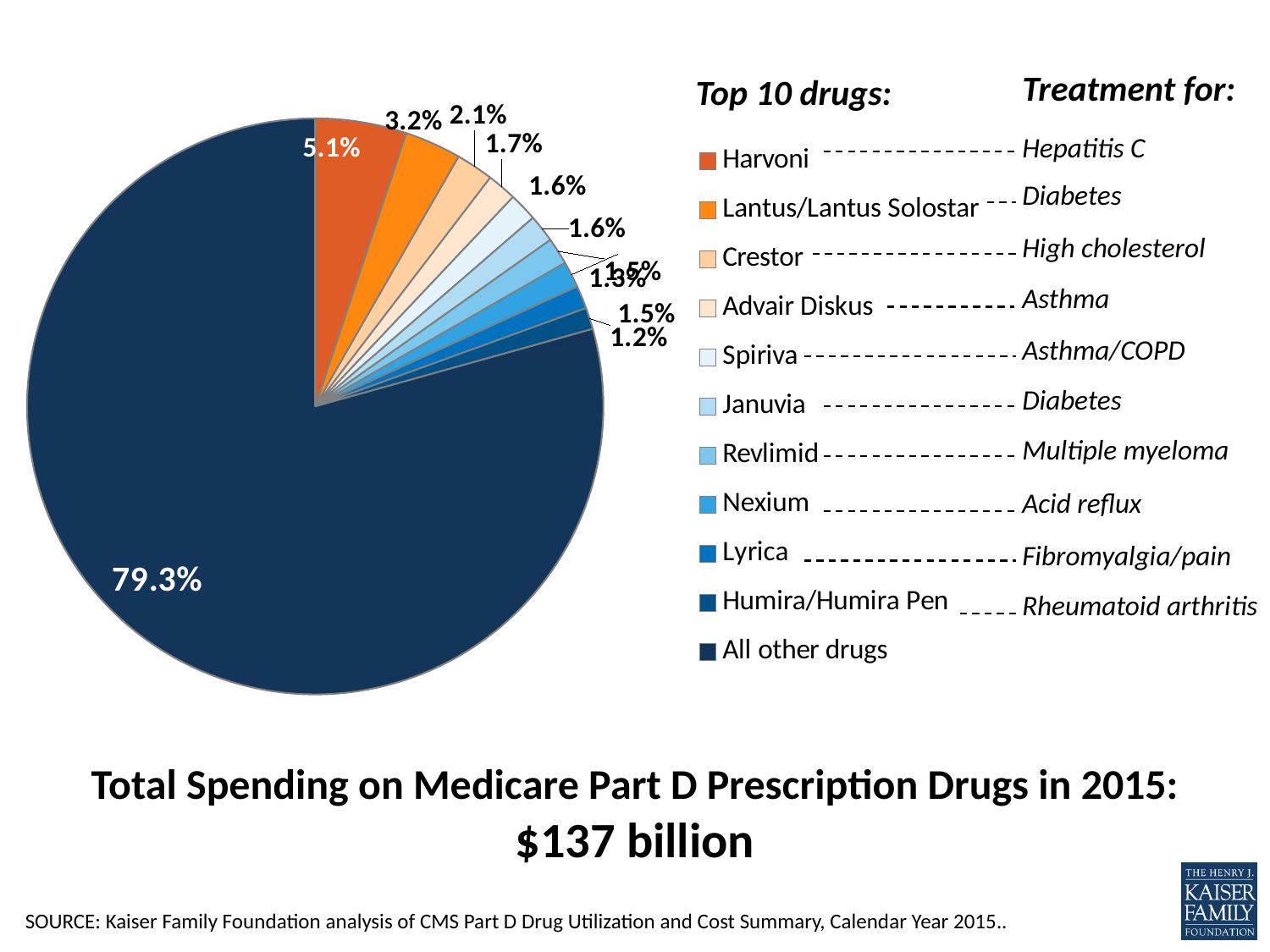
How many categories does the legend list? 11 What is the value for Humira/Humira Pen in the pie chart? 1.2% What type of chart is shown on the slide? Pie chart Which has a larger share, Harvoni or Crestor? Harvoni What percentage of the pie chart is labelled for All other drugs? 79.3% What is the value shown for Lantus/Lantus Solostar? 3.2% What share of spending does Harvoni account for in the pie chart? 5.1% According to the slide, what condition is Harvoni a treatment for? Hepatitis C Which category has the largest slice of the pie chart? All other drugs What is the difference between the shares for Harvoni and Lantus/Lantus Solostar? 1.9% What percentage is shown for Crestor? 2.1% Among the top 10 drugs, which has the largest share of spending? Harvoni